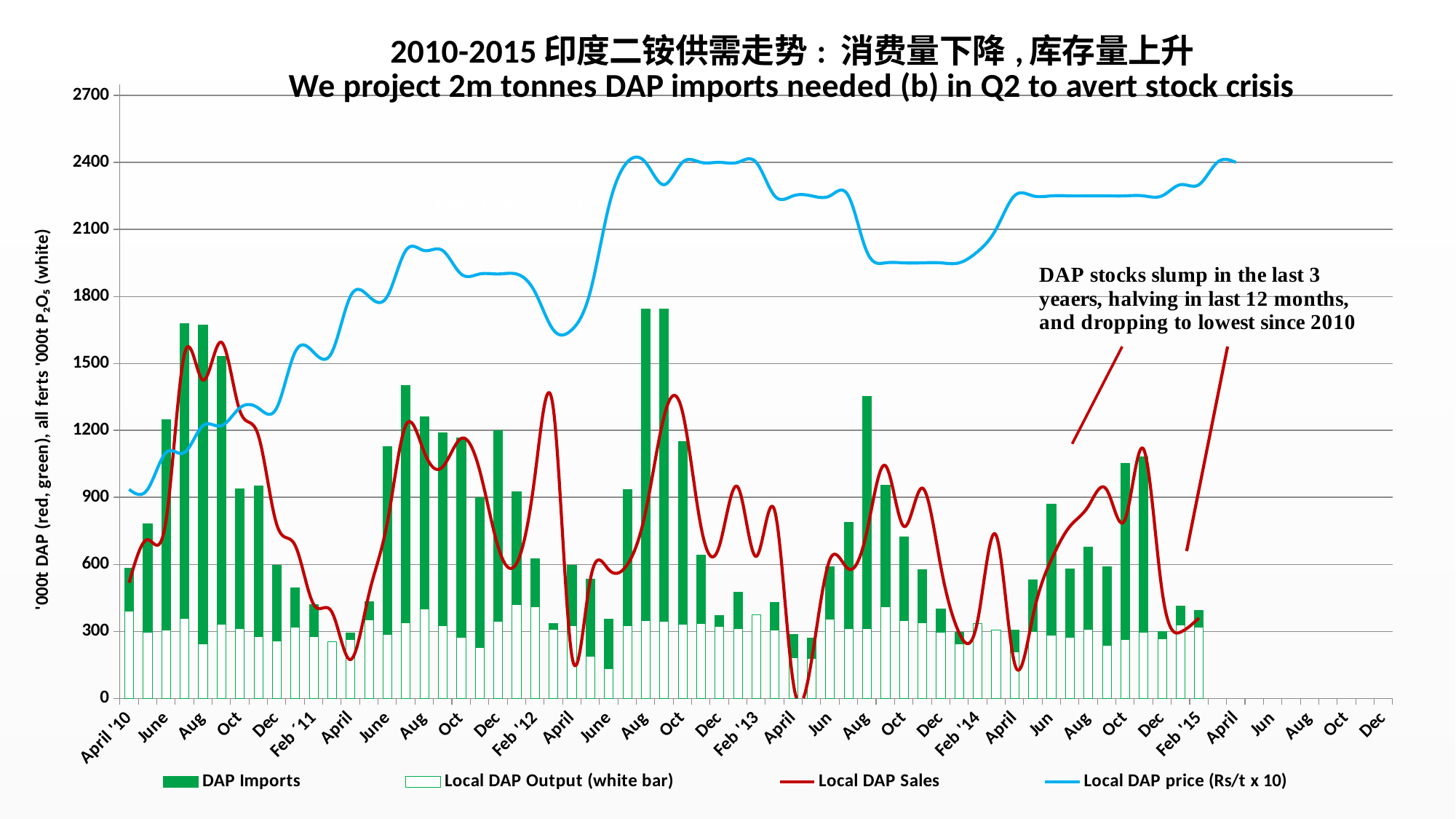
Is the Local DAP price value in Aug '12 greater or less than 2100? greater What kind of chart is this? Combined bar and line chart How many series does the legend list? 4 Is the Local DAP price value in April '10 greater or less than 1200? less Is the DAP Imports bar in April '11 greater or less than 600? less Which series is drawn as the blue line? Local DAP price (Rs/t x 10) Does the Local DAP price line rise or fall between April '10 and Aug '12? rise Does the Local DAP price line rise or fall between Feb '13 and Oct '13? fall What is the highest value shown on the vertical axis? 2700